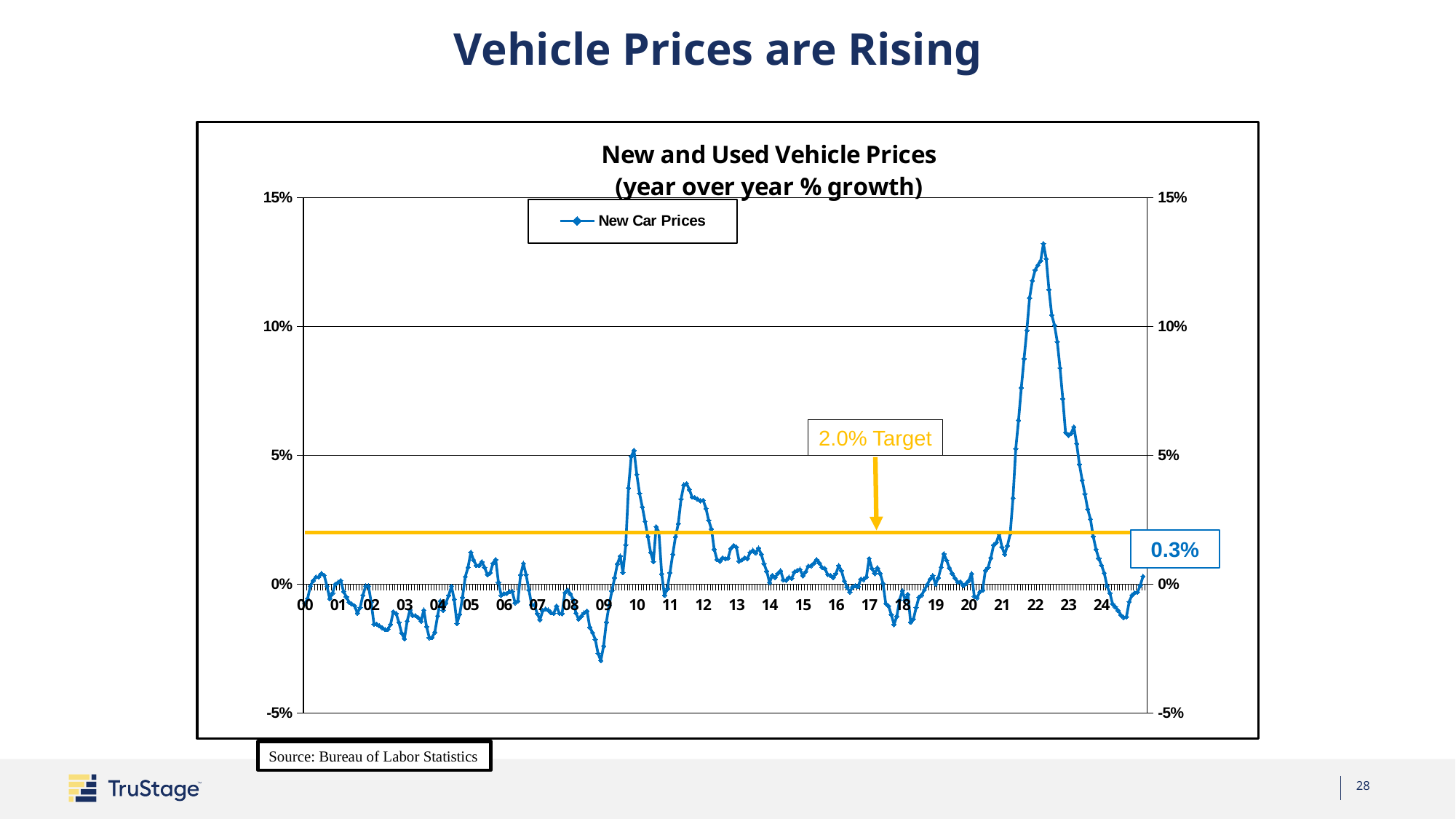
Is the peak value of New Car Prices in 2022 greater or less than 10%? greater Do New Car Prices values rise or fall from the 2022 peak through 2024? fall What target level is marked by the horizontal line on the chart? 2.0% In which year does New Car Prices growth reach its highest value? 22 Is the lowest value of New Car Prices in 2009 greater or less than 0%? less How many series does the chart legend list? 1 What series name is shown in the chart legend? New Car Prices What is the title of the chart? New and Used Vehicle Prices (year over year % growth) Which peak is higher: the one in 2010 or the one in 2022? 2022 What kind of chart is shown on the slide? line chart What is the most recent value of New Car Prices labeled at the end of the line? 0.3%